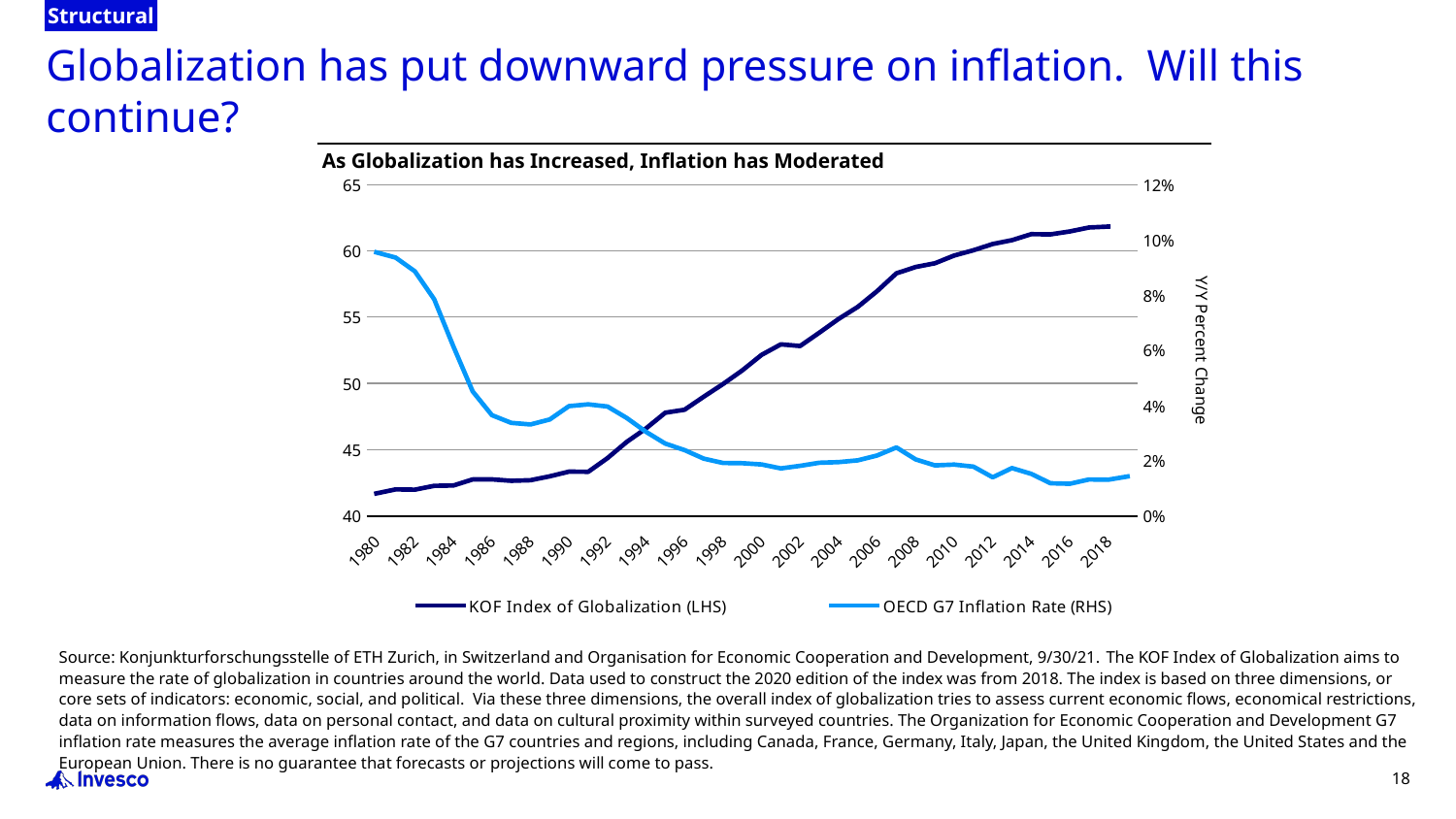
Which series is plotted against the right-hand axis? OECD G7 Inflation Rate (RHS) Is the OECD G7 Inflation Rate for 1980 greater or less than 8%? greater What kind of chart is shown on the slide? Line chart Is the OECD G7 Inflation Rate for 2000 greater or less than 4%? less Is the KOF Index of Globalization value for 1980 greater or less than 45? less Does the OECD G7 Inflation Rate rise or fall from 1980 to 2018? Fall Which is larger, the KOF Index of Globalization in 1980 or in 2018? 2018 Does the KOF Index of Globalization rise or fall from 1980 to 2018? Rise What is the title of the chart? As Globalization has Increased, Inflation has Moderated How many series does the chart's legend list? 2 In which year is the OECD G7 Inflation Rate highest? 1980